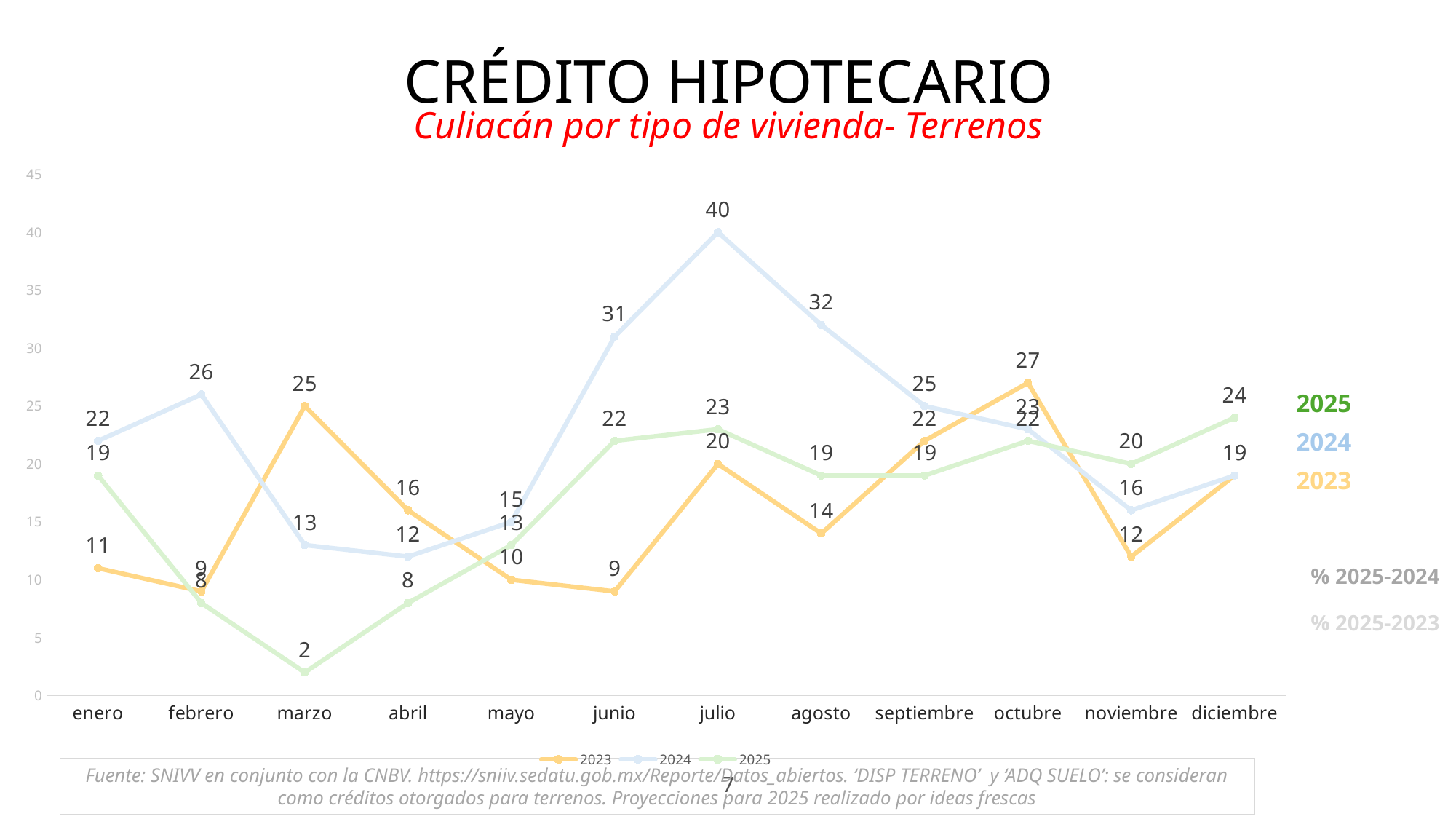
Which month has the highest value in the 2023 series? octubre Which month has the highest value in the 2024 series? julio What is the red subtitle of the chart? Culiacán por tipo de vivienda- Terrenos Which month has the lowest value in the 2025 series? marzo How many months are shown on the x axis? 12 What is the difference between the 2024 and 2023 values for julio? 20 In febrero, which series has the larger value, 2024 or 2023? 2024 What is the value for octubre in the 2023 series? 27 How many series does the legend list? 3 What is the value for julio in the 2024 series? 40 What is the value for junio in the 2025 series? 22 What kind of chart is shown on the slide? Line chart